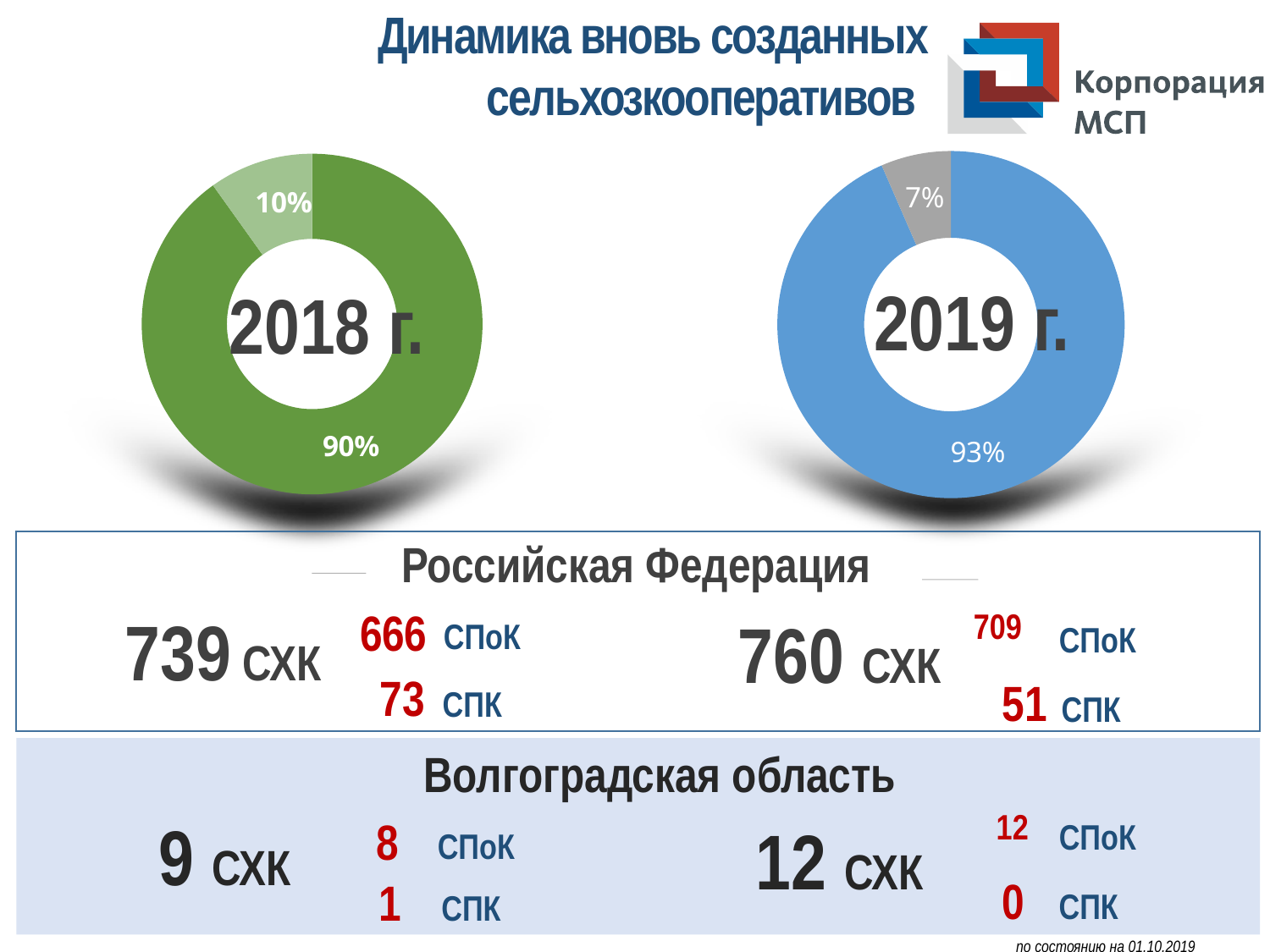
What is the difference between the two slice values in the 2019 г. donut chart? 86% How many slices does the 2018 г. donut chart have? 2 In the 2018 г. donut chart, what percentage is shown on the larger slice? 90% How many slices does the 2019 г. donut chart have? 2 Which chart has the larger smaller-slice share, the 2018 г. chart or the 2019 г. chart? 2018 г. What kind of chart is used for the 2018 г. chart on the left? pie chart (donut) What is the difference between the two slice values in the 2018 г. donut chart? 80% In the 2019 г. donut chart, what percentage is shown on the smaller slice? 7% In the 2019 г. donut chart, what percentage is shown on the larger slice? 93% What colour is the larger slice in the 2018 г. donut chart? green What colour is the larger slice in the 2019 г. donut chart? blue In the 2018 г. donut chart, what percentage is shown on the smaller slice? 10%